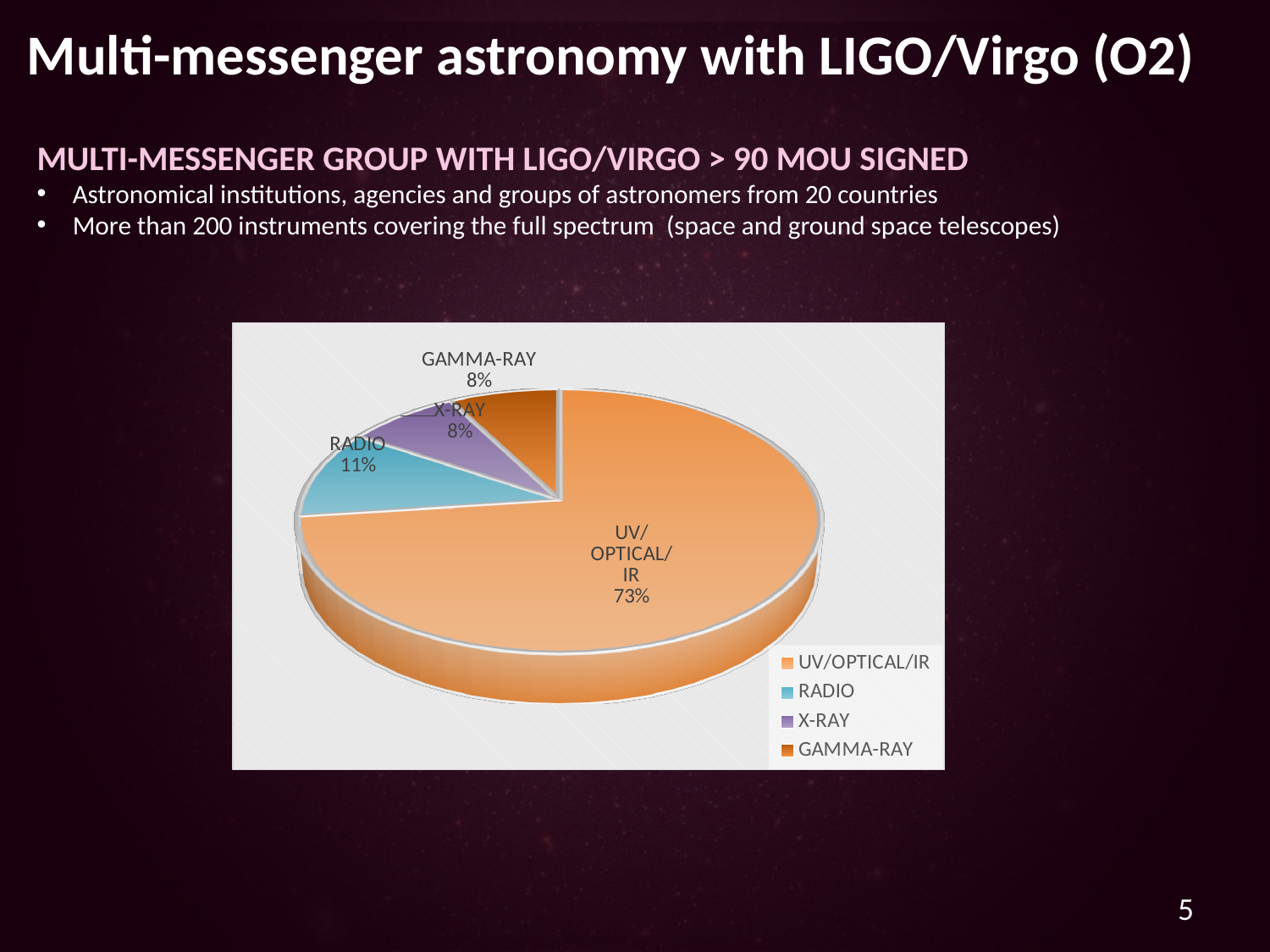
How many slices does the pie chart have? 4 What share of the pie does X-RAY account for? 8% How many entries does the legend list? 4 What share of the pie does UV/OPTICAL/IR account for? 73% What share of the pie does RADIO account for? 11% What is the difference in percentage points between the UV/OPTICAL/IR slice and the RADIO slice? 62 Which category has the largest slice of the pie? UV/OPTICAL/IR Which is larger, the RADIO slice or the X-RAY slice? RADIO What kind of chart is shown on the slide? pie chart What is the difference in percentage points between the RADIO slice and the GAMMA-RAY slice? 3 Which legend entry is shown in blue? RADIO